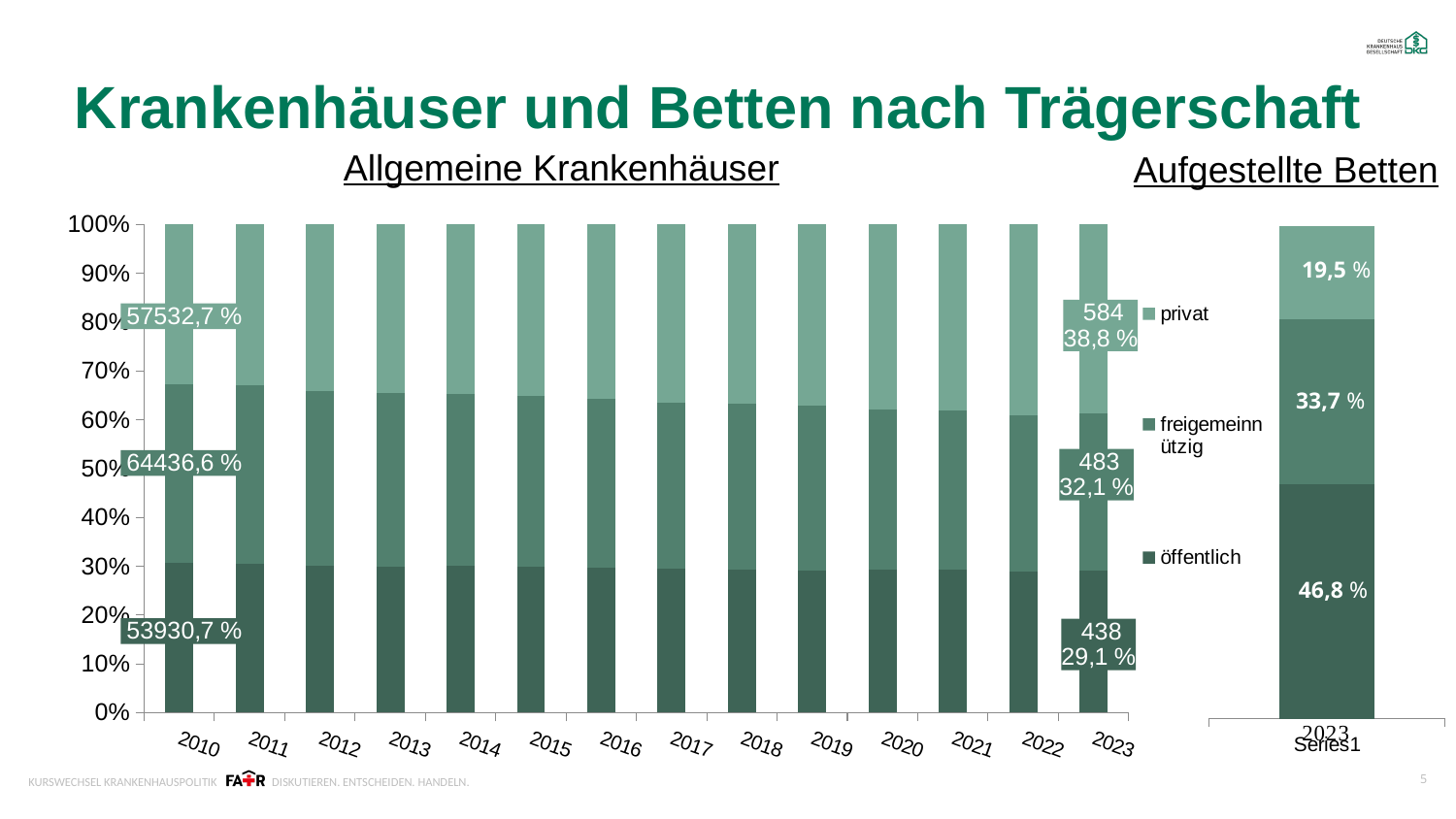
In the 'Allgemeine Krankenhäuser' chart, what is the difference between the number of privat hospitals and öffentlich hospitals in 2023? 146 What kind of chart is the 'Allgemeine Krankenhäuser' chart? Stacked bar chart In the 'Allgemeine Krankenhäuser' chart, does the share of privat hospitals rise or fall from 2010 to 2023? rise In the 'Allgemeine Krankenhäuser' chart, how many freigemeinnützig hospitals are there in 2023? 483 In the 'Allgemeine Krankenhäuser' chart, how many public hospitals (öffentlich) are there in 2023? 438 In the 'Aufgestellte Betten' chart, which segment has the smallest share? privat In the 'Aufgestellte Betten' chart, what is the difference between the öffentlich share and the privat share? 27,3 % In the 'Allgemeine Krankenhäuser' chart, how many series does the legend list? 3 In the 'Allgemeine Krankenhäuser' chart, how many years are shown on the x axis? 14 In the 'Allgemeine Krankenhäuser' chart, what percentage share do private hospitals (privat) have in 2023? 38,8 % In the 'Aufgestellte Betten' chart, what share of beds is öffentlich in 2023? 46,8 % In the 'Allgemeine Krankenhäuser' chart, which is larger in 2023: the number of privat hospitals or the number of öffentlich hospitals? privat